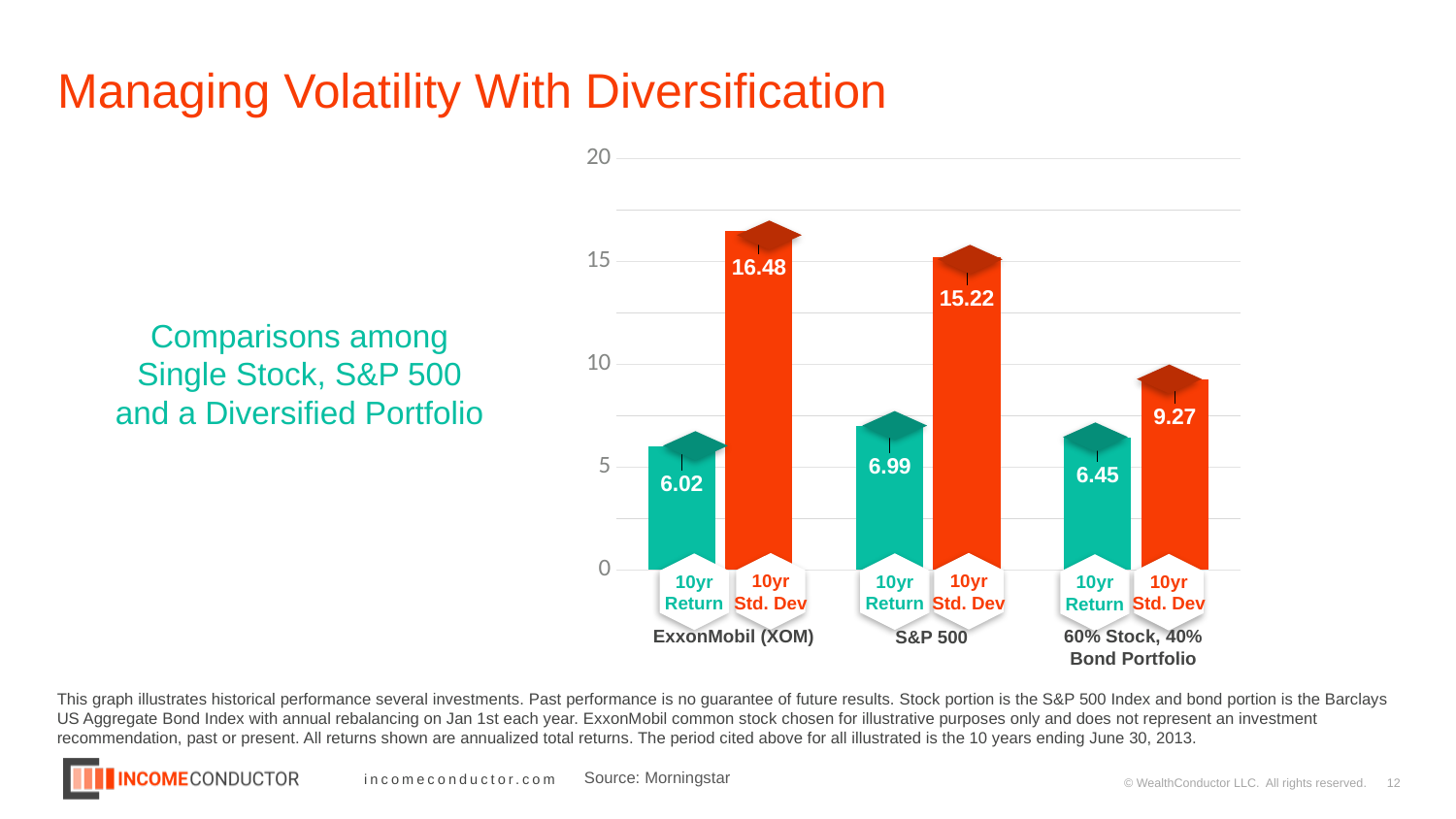
What colour are the 10yr Std. Dev bars? Orange What is the 10yr Std. Dev for the S&P 500? 15.22 What is the difference between the 10yr Std. Dev of ExxonMobil (XOM) and that of the 60% Stock, 40% Bond Portfolio? 7.21 What is the 10yr Return for the 60% Stock, 40% Bond Portfolio? 6.45 How many investments are compared on the chart? 3 What is the 10yr Std. Dev for the 60% Stock, 40% Bond Portfolio? 9.27 What is the 10yr Return for ExxonMobil (XOM)? 6.02 What kind of chart is shown on the slide? Bar chart Which investment has the highest 10yr Std. Dev? ExxonMobil (XOM) Which investment has the lowest 10yr Return? ExxonMobil (XOM) Is the 10yr Std. Dev for the S&P 500 greater or less than 10? greater Which is larger: the 10yr Return for the S&P 500 or the 10yr Return for the 60% Stock, 40% Bond Portfolio? S&P 500